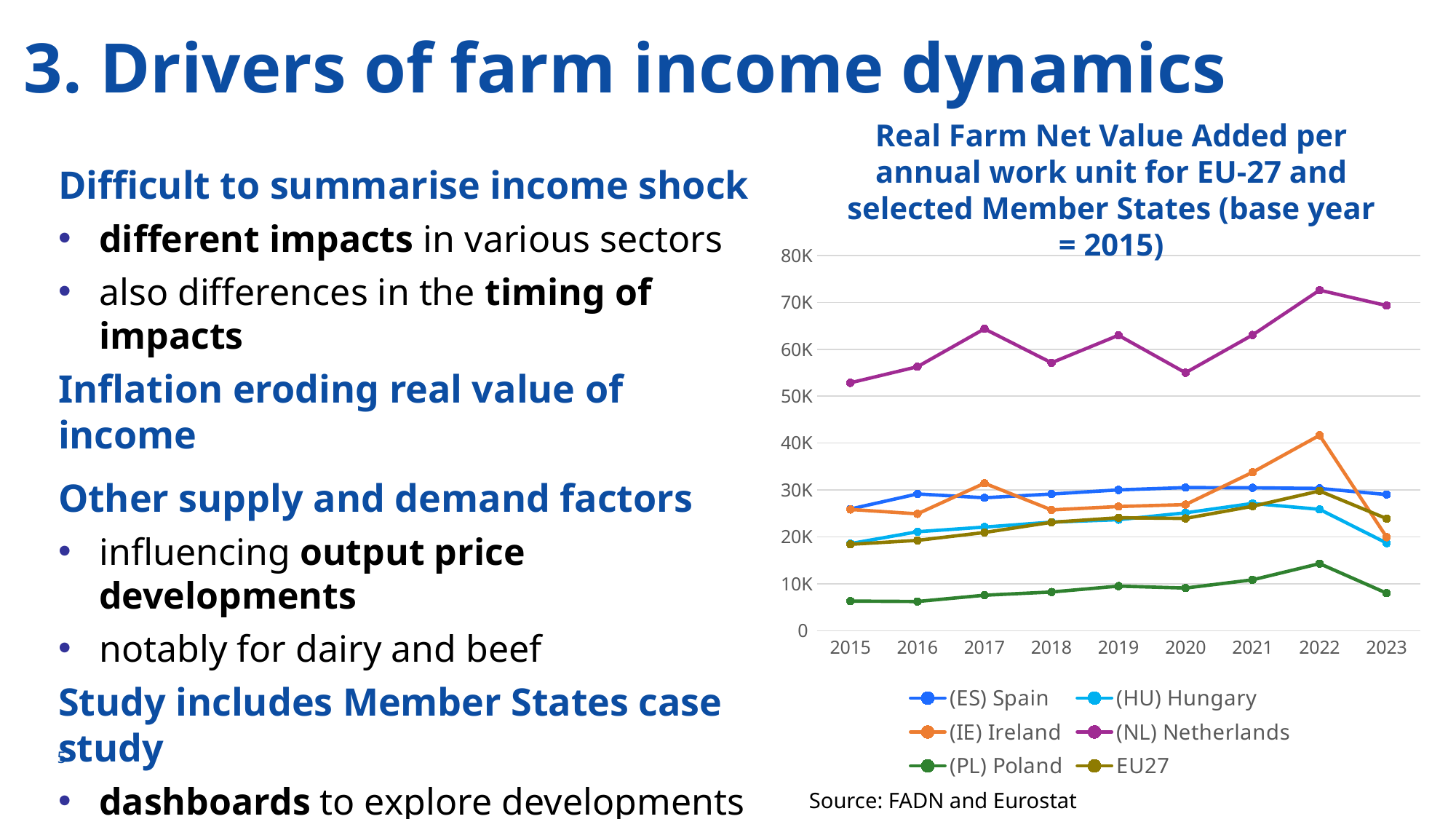
Which Member State has the highest Real Farm Net Value Added per annual work unit in 2022? (NL) Netherlands How many years are plotted along the x axis? 9 What kind of chart is shown on the slide? line chart Which series has the lowest values across the whole period? (PL) Poland Is the value for Ireland in 2022 greater or less than 30K? greater Is the value for the Netherlands in 2022 greater or less than 70K? greater Is the value for Poland in 2022 greater or less than 20K? less In which year does the Netherlands line reach its peak? 2022 In which year does the Ireland line reach its highest point? 2022 Which is larger in 2023, the value for Spain or the value for Hungary? (ES) Spain How many series does the legend list? 6 Does the Poland line rise or fall from 2022 to 2023? fall